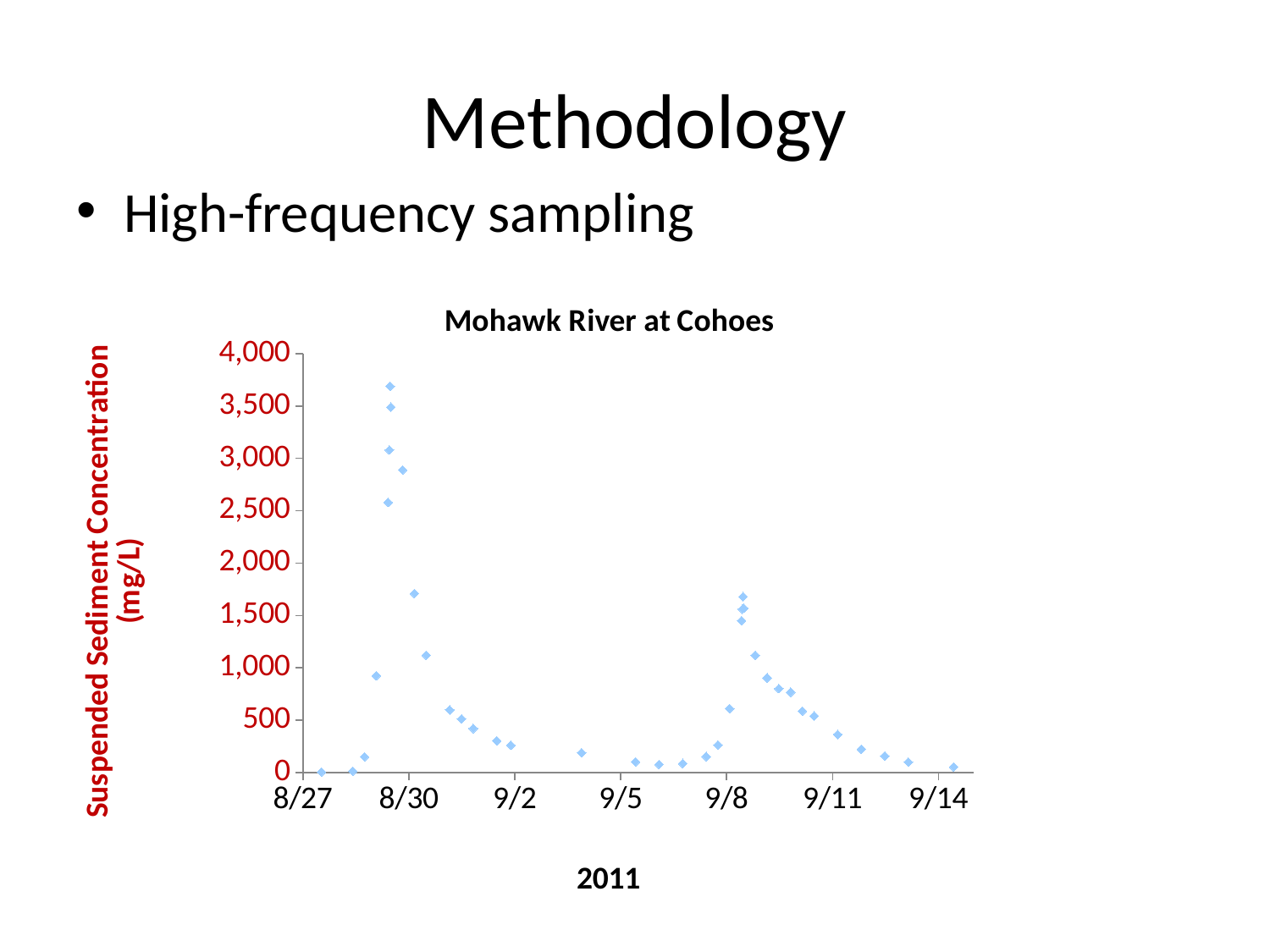
What kind of chart is shown on the slide? scatter chart Do the values rise or fall between 9/8 and 9/14? fall Is the value plotted near 9/14 greater or less than 500? less Is the highest value of the second peak, near 9/8, greater or less than 2,000? less Is the value plotted near 9/5 greater or less than 1,000? less Which peak is higher, the one near 8/30 or the one near 9/8? the one near 8/30 Do the values rise or fall between 8/30 and 9/5? fall What is the label of the vertical axis of the chart? Suspended Sediment Concentration (mg/L) What is the highest tick value shown on the vertical axis? 4,000 What is the title of the chart? Mohawk River at Cohoes